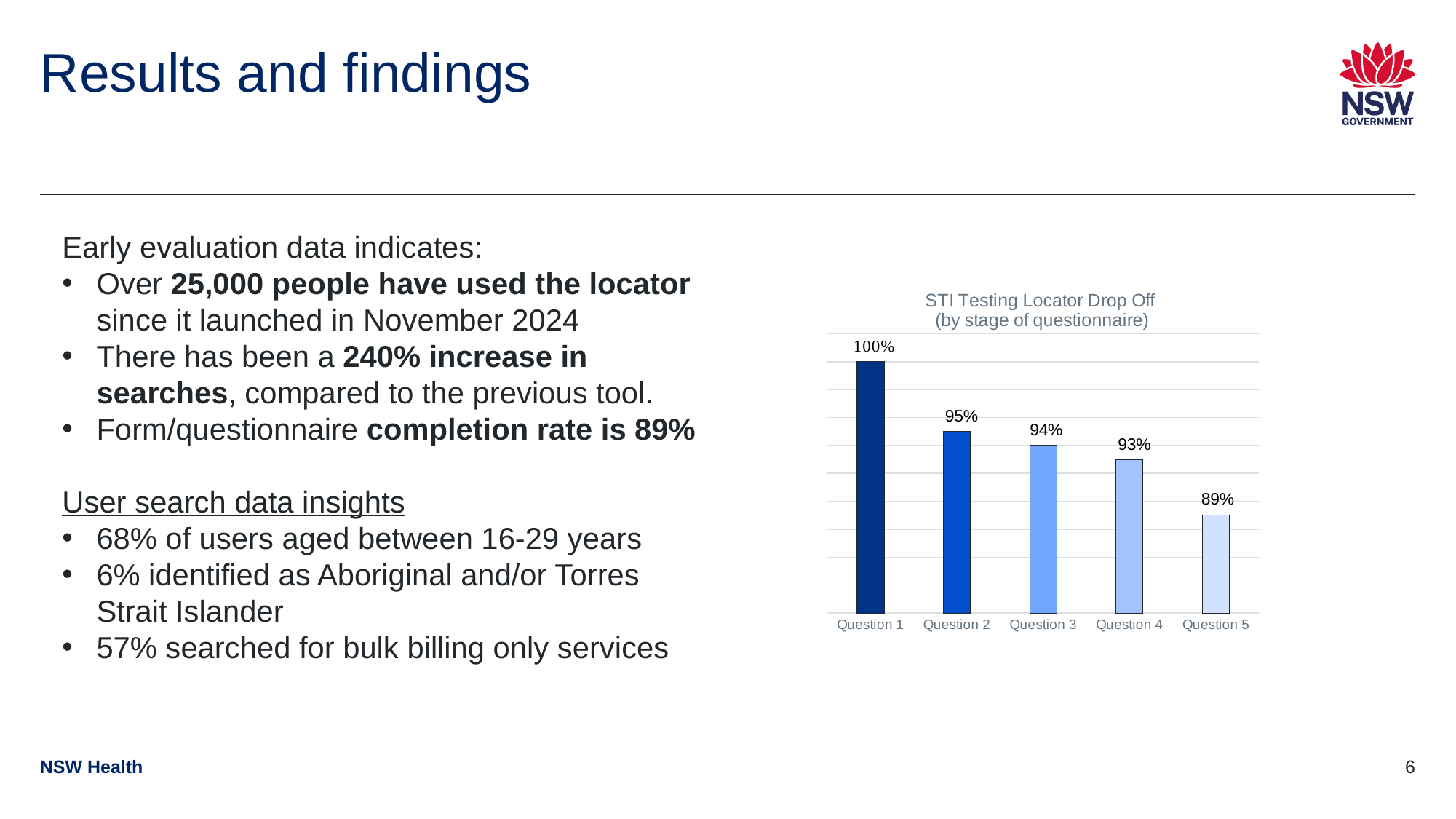
What is the difference between the values for Question 2 and Question 4 in the STI Testing Locator Drop Off chart? 2% Do the values in the STI Testing Locator Drop Off chart rise or fall from Question 1 to Question 5? Fall Which question has the highest value in the STI Testing Locator Drop Off chart? Question 1 Which is larger in the STI Testing Locator Drop Off chart, the value for Question 2 or Question 5? Question 2 How many questions (categories) are shown in the STI Testing Locator Drop Off chart? 5 What is the value for Question 5 in the STI Testing Locator Drop Off chart? 89% What is the value for Question 3 in the STI Testing Locator Drop Off chart? 94% What is the subtitle shown in parentheses under the STI Testing Locator Drop Off chart title? (by stage of questionnaire) What is the difference between the values for Question 1 and Question 5 in the STI Testing Locator Drop Off chart? 11% What is the value for Question 1 in the STI Testing Locator Drop Off chart? 100% What kind of chart is the STI Testing Locator Drop Off chart? Bar chart Which question has the lowest value in the STI Testing Locator Drop Off chart? Question 5